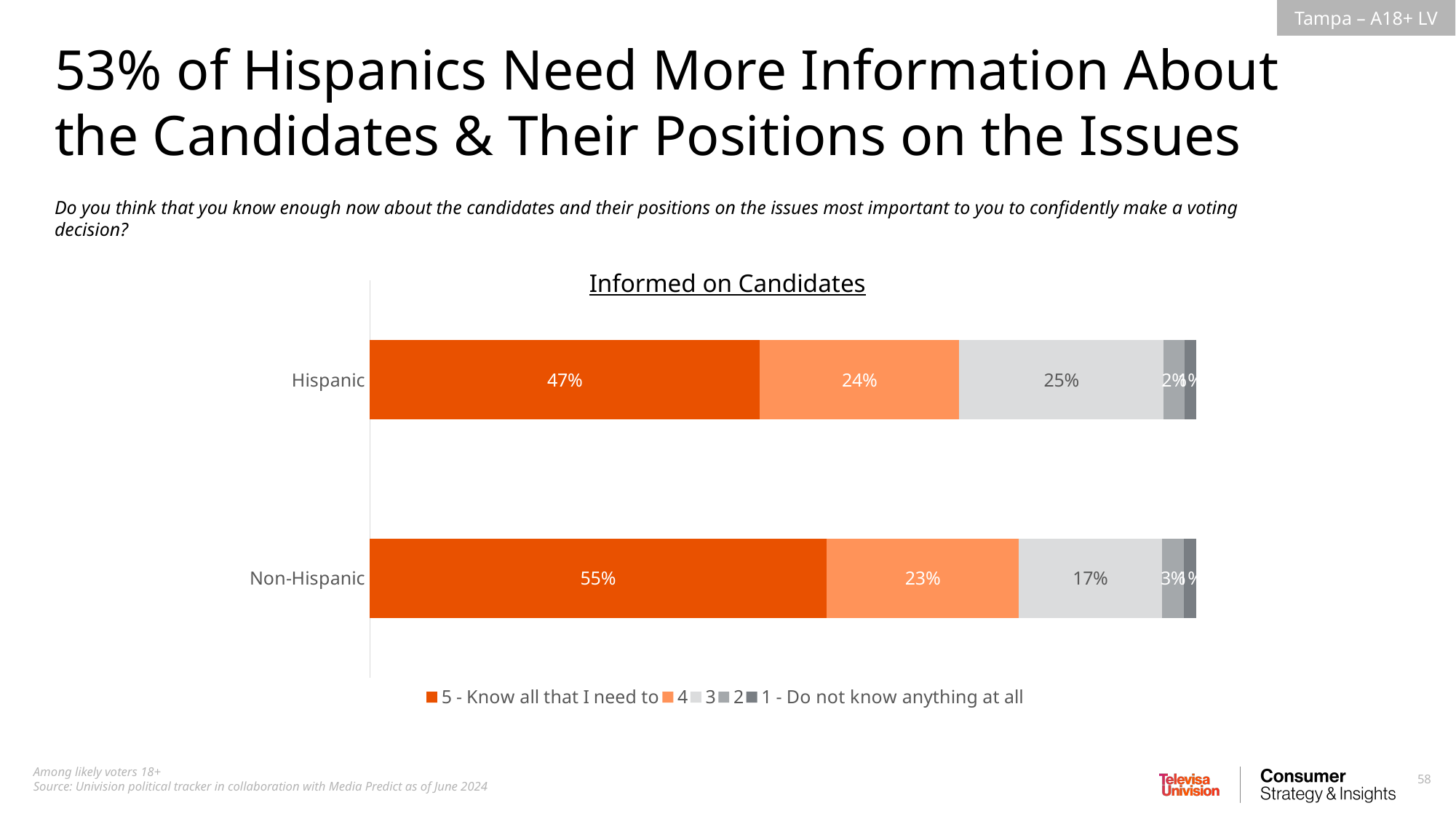
Which response category has the largest share among Hispanic respondents? 5 - Know all that I need to What percentage of Hispanic respondents gave a rating of 4? 24% What percentage of Non-Hispanic respondents answered "5 - Know all that I need to"? 55% What is the title of the chart? Informed on Candidates What percentage of Hispanic respondents answered "5 - Know all that I need to"? 47% What type of chart is shown on the slide? Stacked bar chart What percentage of Hispanic respondents gave a rating of 3? 25% Which group has the larger share answering "5 - Know all that I need to", Hispanic or Non-Hispanic? Non-Hispanic What is the difference in percentage points between Non-Hispanic and Hispanic respondents answering "5 - Know all that I need to"? 8 percentage points How many groups (bars) are shown in the chart? 2 What percentage of Non-Hispanic respondents gave a rating of 3? 17% How many series does the legend list? 5